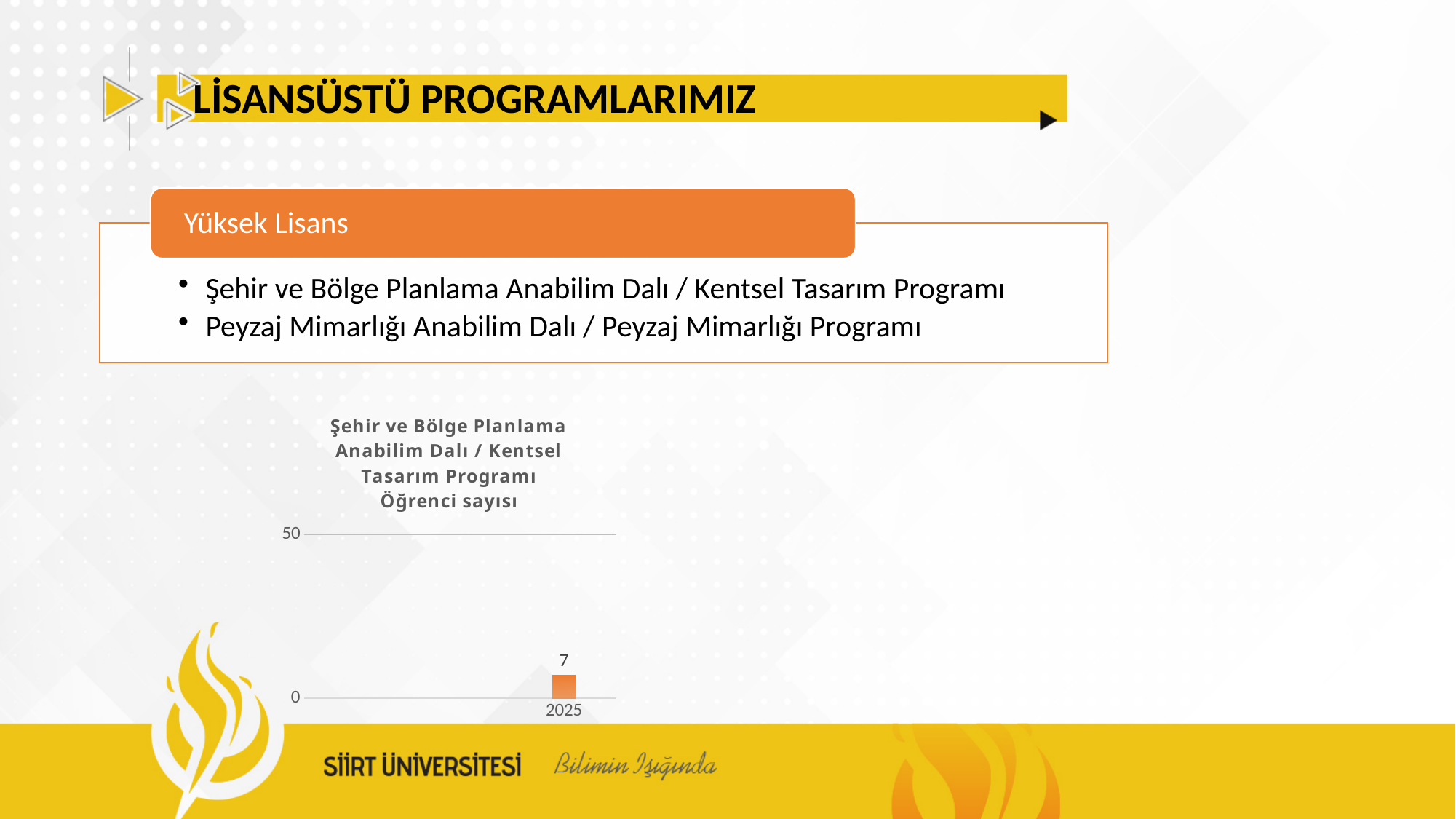
What is the title of the chart? Şehir ve Bölge Planlama Anabilim Dalı / Kentsel Tasarım Programı Öğrenci sayısı What is the value of the bar for 2025 in the chart? 7 How many bars are plotted in the chart? 1 What colour is the bar in the chart? orange Is the value for 2025 greater or less than 50? less What kind of chart is shown on the slide? bar chart Which year is shown on the x axis of the chart? 2025 What is the highest value shown on the chart's vertical axis? 50